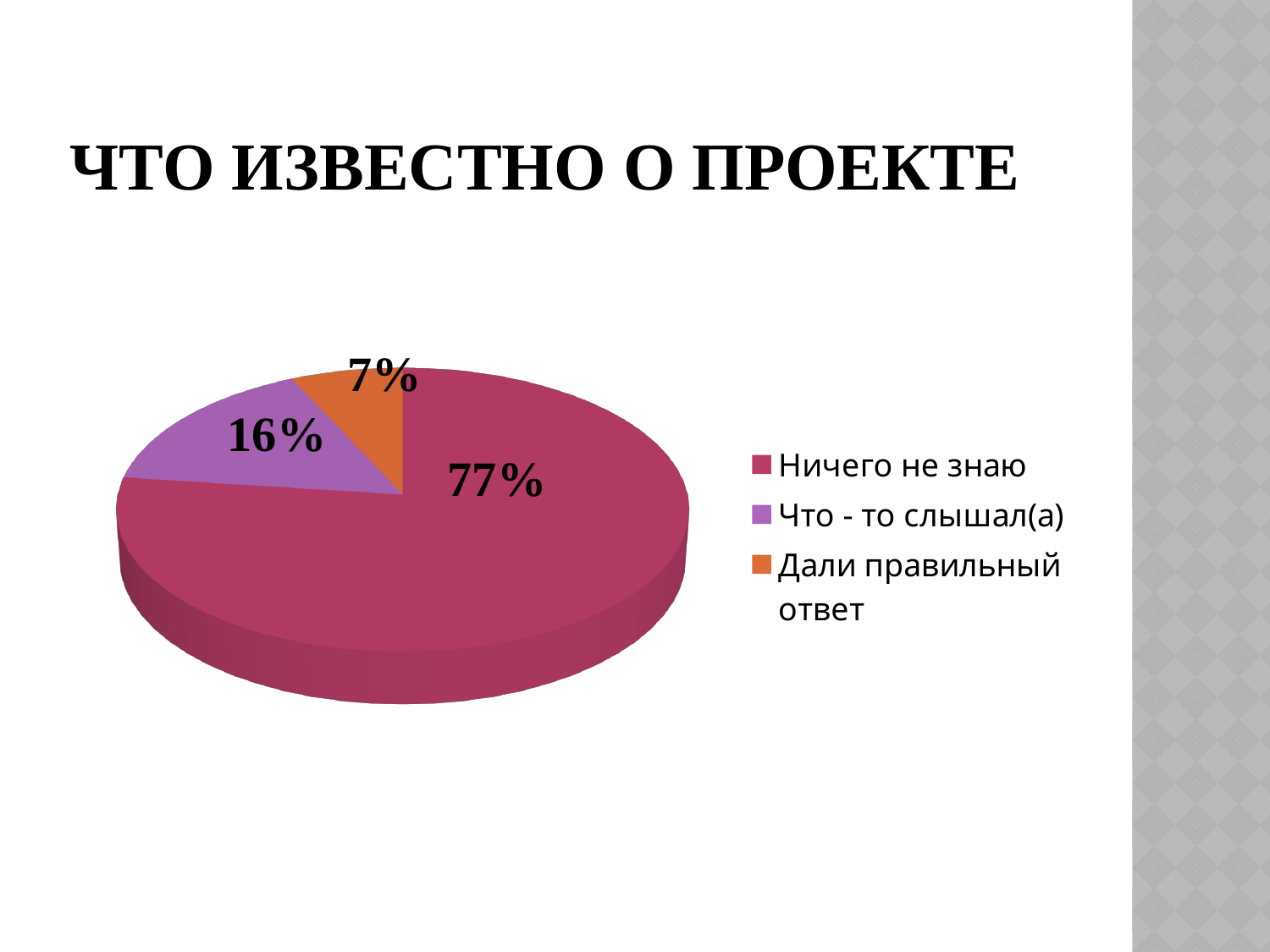
What kind of chart is shown on the slide? Pie chart Which category has the largest slice of the pie? Ничего не знаю What is the difference in percentage points between "Ничего не знаю" and "Что - то слышал(а)"? 61 What is the difference in percentage points between "Что - то слышал(а)" and "Дали правильный ответ"? 9 What share of the pie does "Дали правильный ответ" take? 7% What share of the pie does "Ничего не знаю" take? 77% What share of the pie does "Что - то слышал(а)" take? 16% Which is larger, the slice for "Что - то слышал(а)" or the slice for "Дали правильный ответ"? Что - то слышал(а) Which category has the smallest slice of the pie? Дали правильный ответ How many slices does the pie chart have? 3 What is the title of the slide? ЧТО ИЗВЕСТНО О ПРОЕКТЕ What colour is the slice for "Дали правильный ответ"? Orange